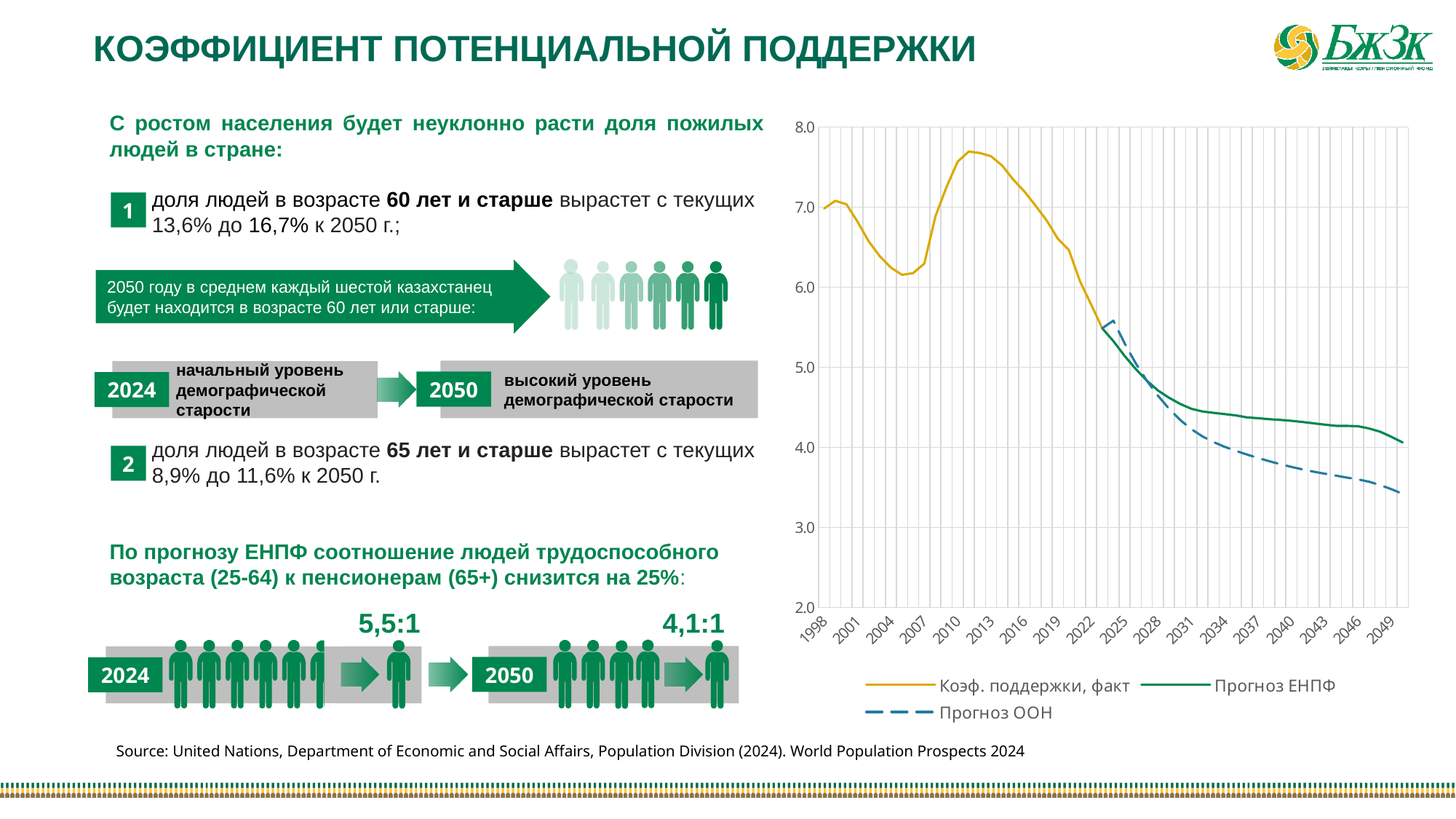
In the line chart, which forecast is higher in 2049: 'Прогноз ЕНПФ' or 'Прогноз ООН'? Прогноз ЕНПФ How many year labels are shown on the x axis of the line chart? 18 In the line chart, is the value of 'Коэф. поддержки, факт' in 2013 greater or less than 7.0? greater In the line chart, does the 'Коэф. поддержки, факт' series rise or fall between 2013 and 2022? fall In the line chart, does the 'Прогноз ООН' series rise or fall from 2025 to 2049? fall In the line chart, is the value of 'Прогноз ООН' in 2049 greater or less than 4.0? less In the line chart, is the value of 'Коэф. поддержки, факт' in 2022 greater or less than 6.0? less How many series does the legend of the line chart list? 3 What is the highest value shown on the y axis of the line chart? 8.0 Which series in the line chart is drawn with a dashed line? Прогноз ООН What kind of chart is shown on the right side of the slide? line chart